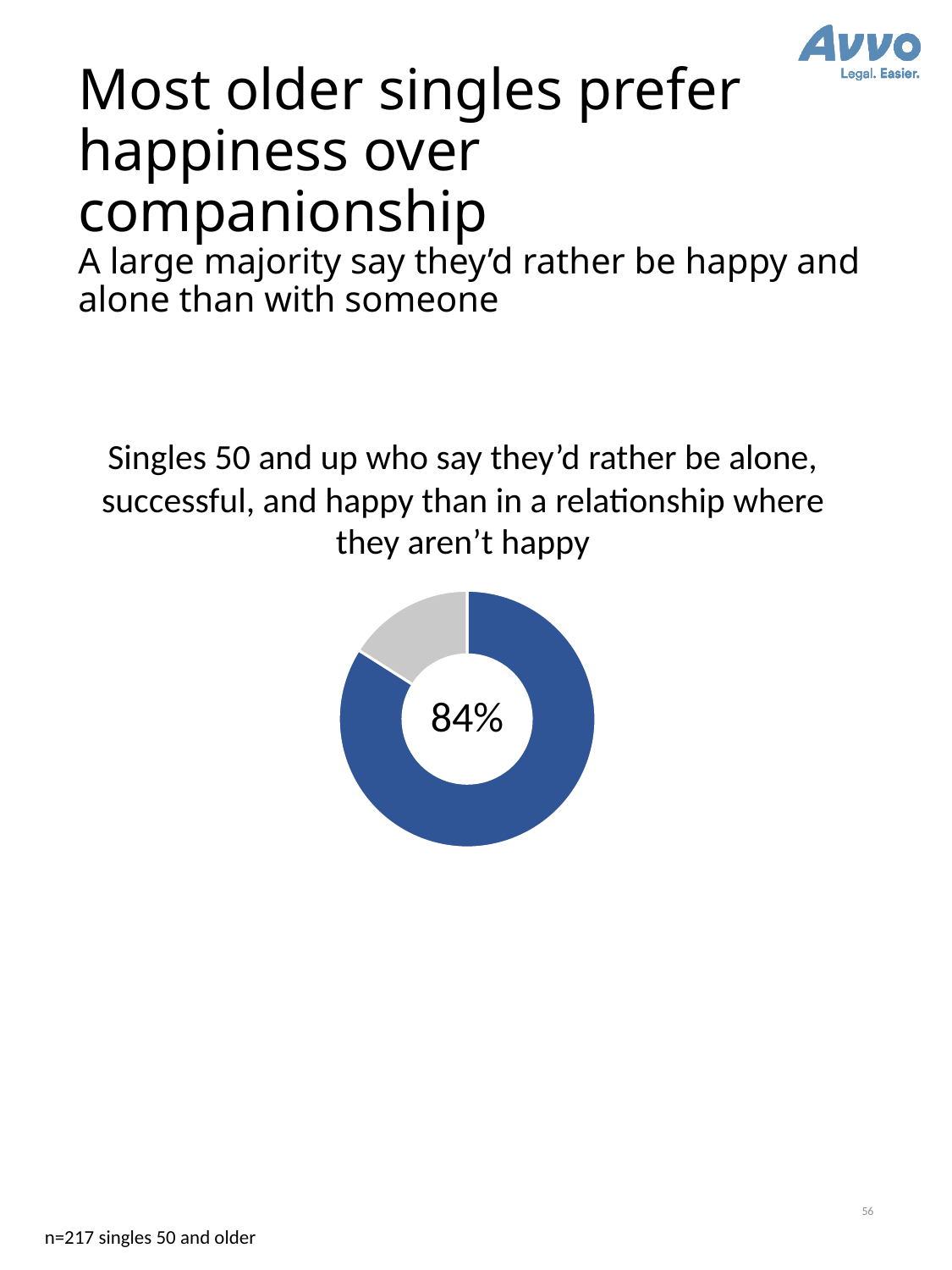
Is the grey slice of the donut chart greater or less than 50% of the whole? less How many slices does the donut chart have? 2 Is the blue slice of the donut chart greater or less than 50% of the whole? greater What colour is the slice representing the 84% value? Blue What share of singles 50 and up say they'd rather be alone, successful, and happy than in a relationship where they aren't happy? 84% What is the sample size noted at the bottom of the slide? n=217 singles 50 and older What kind of chart is shown on the slide? Donut (pie) chart Which slice of the donut chart is larger, the blue one or the grey one? The blue one What percentage is shown in the centre of the donut chart? 84%